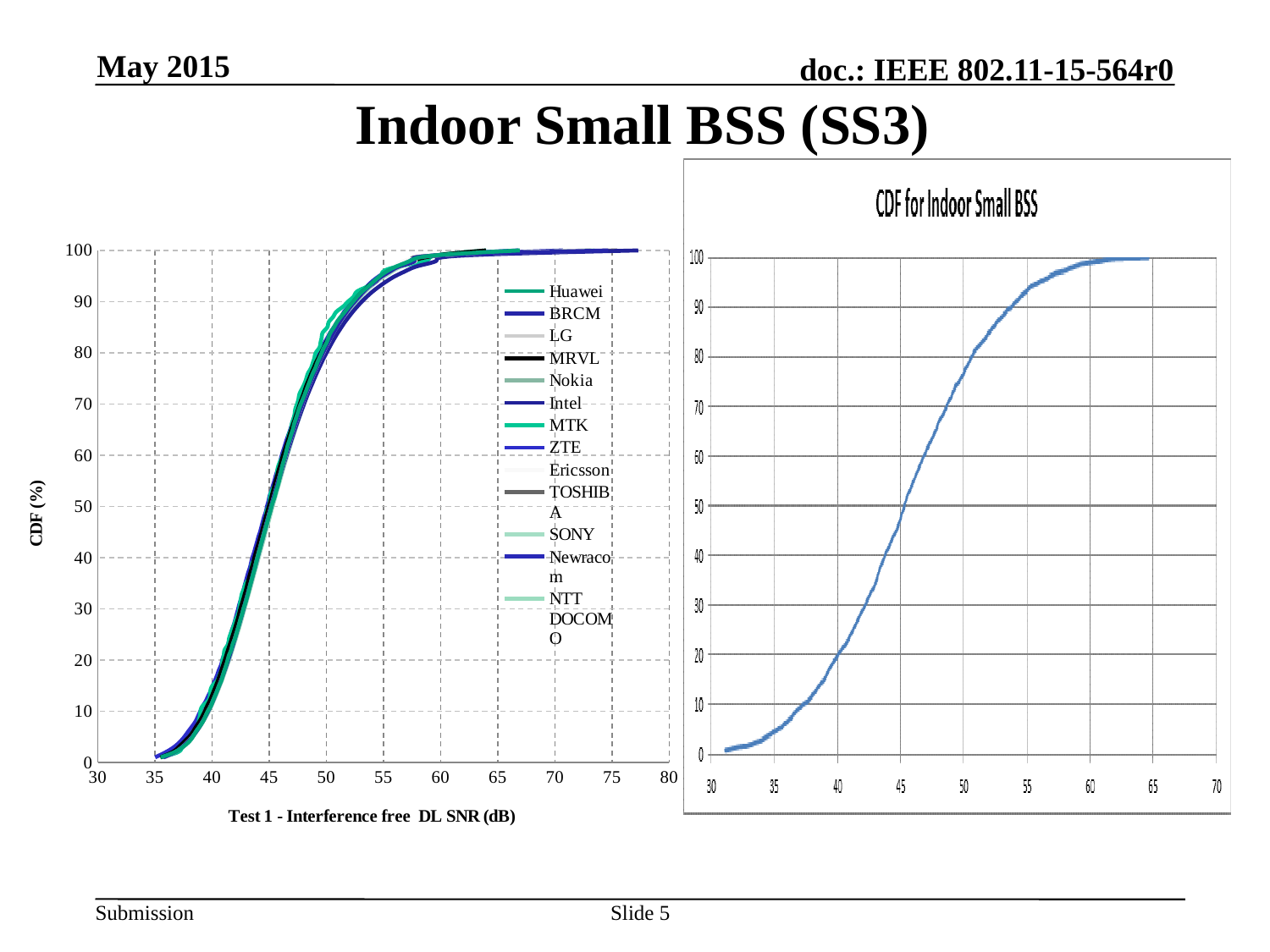
In the left chart, is the CDF value of the curves at 55 dB greater or less than 90? greater In the right chart, is the CDF value at x = 35 greater or less than 10? less What is the x-axis label of the left chart? Test 1 - Interference free DL SNR (dB) In the left chart, do the CDF curves rise or fall as the DL SNR increases along the x axis? rise In the right chart, does the curve rise or fall as the x-axis value increases? rise What kind of chart is the right chart on the slide? line chart How many series does the legend of the left chart list? 13 What is the maximum value shown on the x axis of the left chart? 80 What kind of chart is the left chart on the slide? line chart In the left chart, is the CDF value of the curves at 37 dB greater or less than 10? less What is the title of the right chart? CDF for Indoor Small BSS